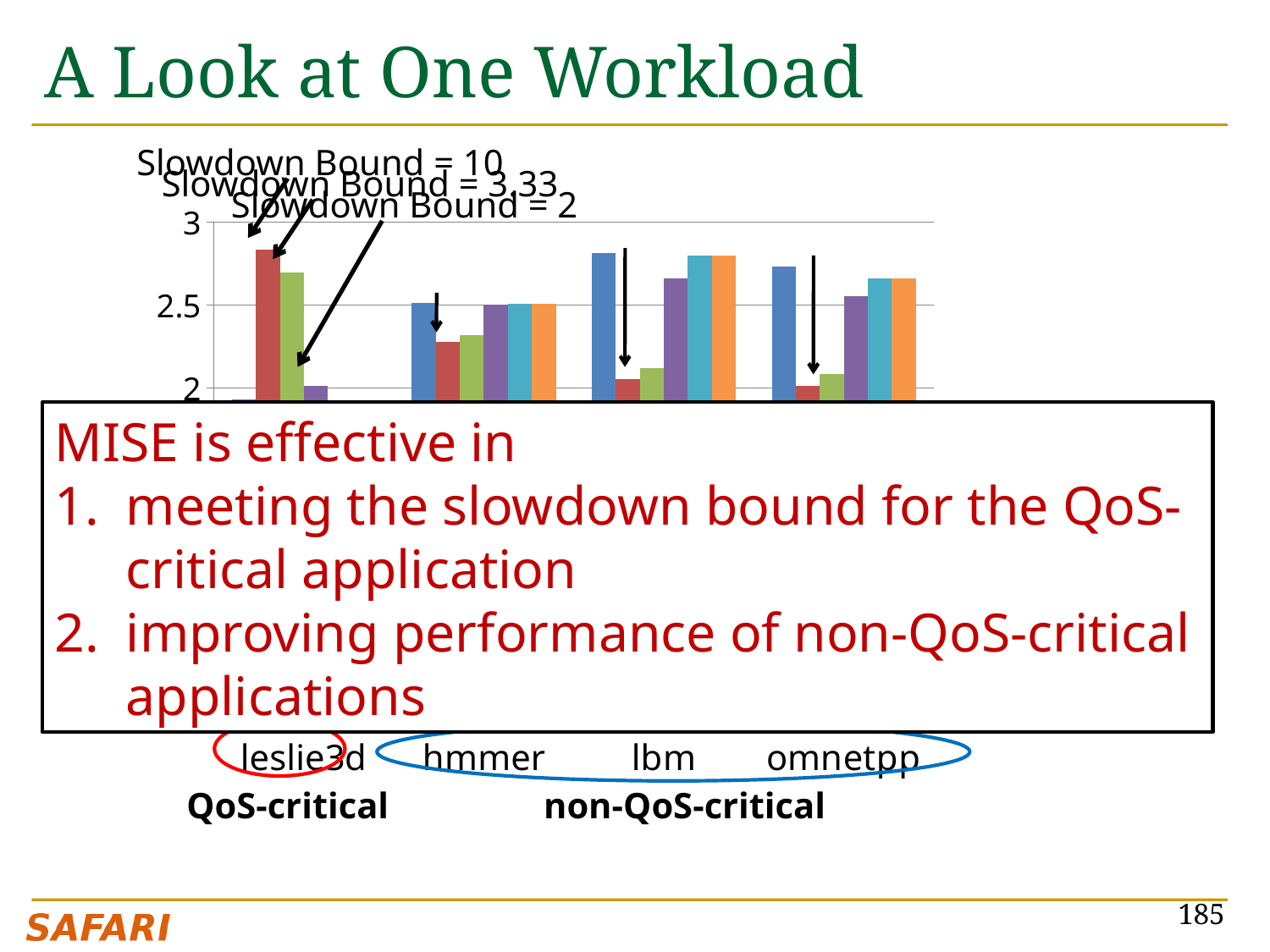
Is the value of the tallest bar for leslie3d greater or less than 2.5? greater Is the value of the tallest bar for omnetpp greater or less than 2.5? greater Is the value of the shortest bar for hmmer greater or less than 2.5? less Which is larger: the shortest bar for hmmer or the shortest bar for lbm? hmmer What kind of chart is shown on the slide? bar chart How many application categories are labeled on the x axis of the chart? 4 Which applications on the x axis are grouped as non-QoS-critical? hmmer, lbm, omnetpp Which application on the x axis is labeled as QoS-critical? leslie3d Which is larger: the tallest bar for hmmer or the tallest bar for lbm? lbm